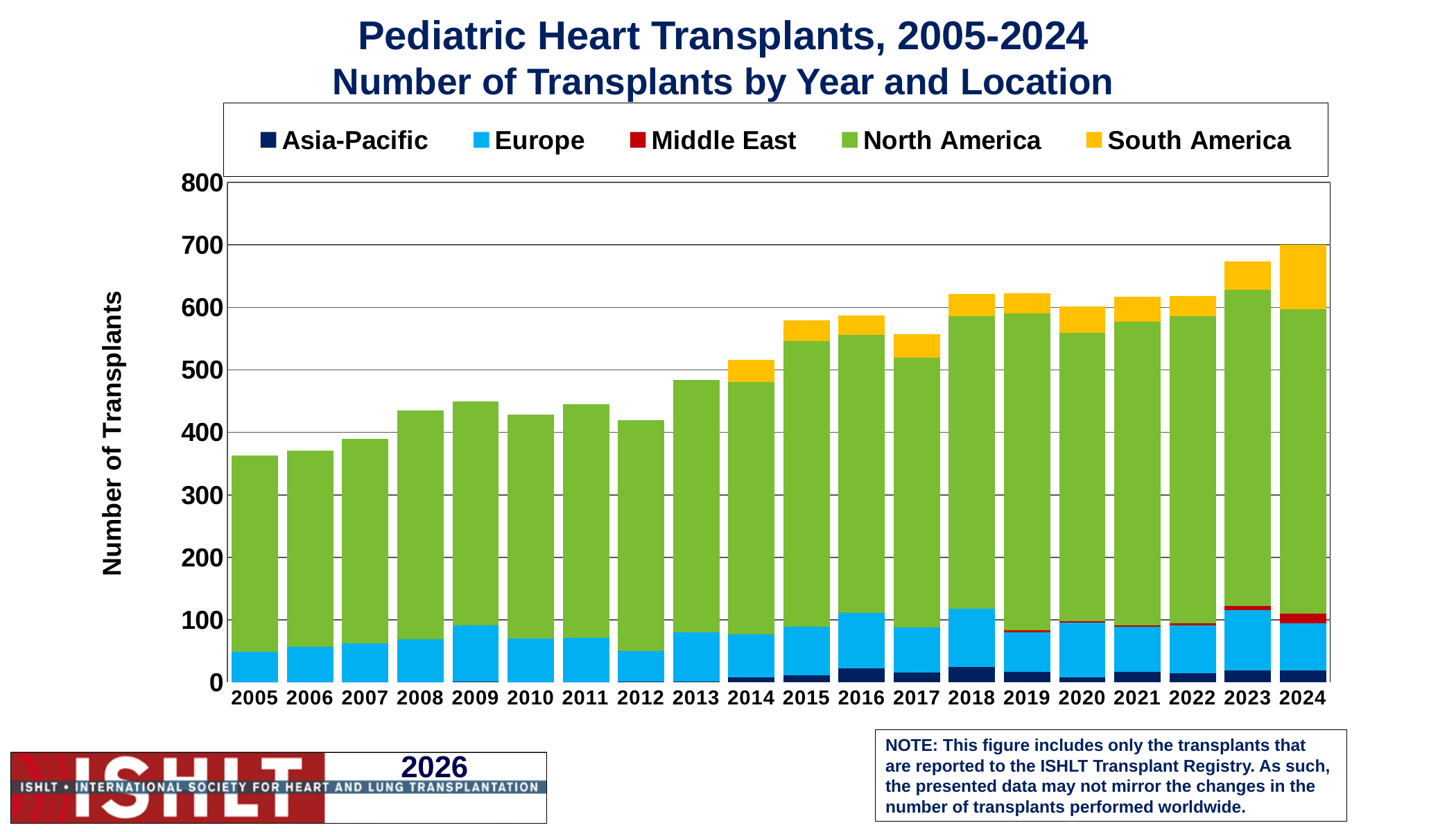
Is the total number of transplants in 2005 greater or less than 400? less How many years are shown along the x axis of the chart? 20 How many series does the legend list? 5 What kind of chart is shown on the slide? Stacked bar chart Is the total number of transplants in 2024 greater or less than 600? greater Is the total number of transplants in 2016 greater or less than 500? greater Which year has the larger total number of transplants, 2017 or 2018? 2018 Which year has the larger total number of transplants, 2022 or 2023? 2023 What is the label of the y axis? Number of Transplants Which year has the lowest total number of transplants? 2005 Overall, do the total numbers of transplants rise or fall from 2005 to 2024? rise Which year has the highest total number of transplants? 2024